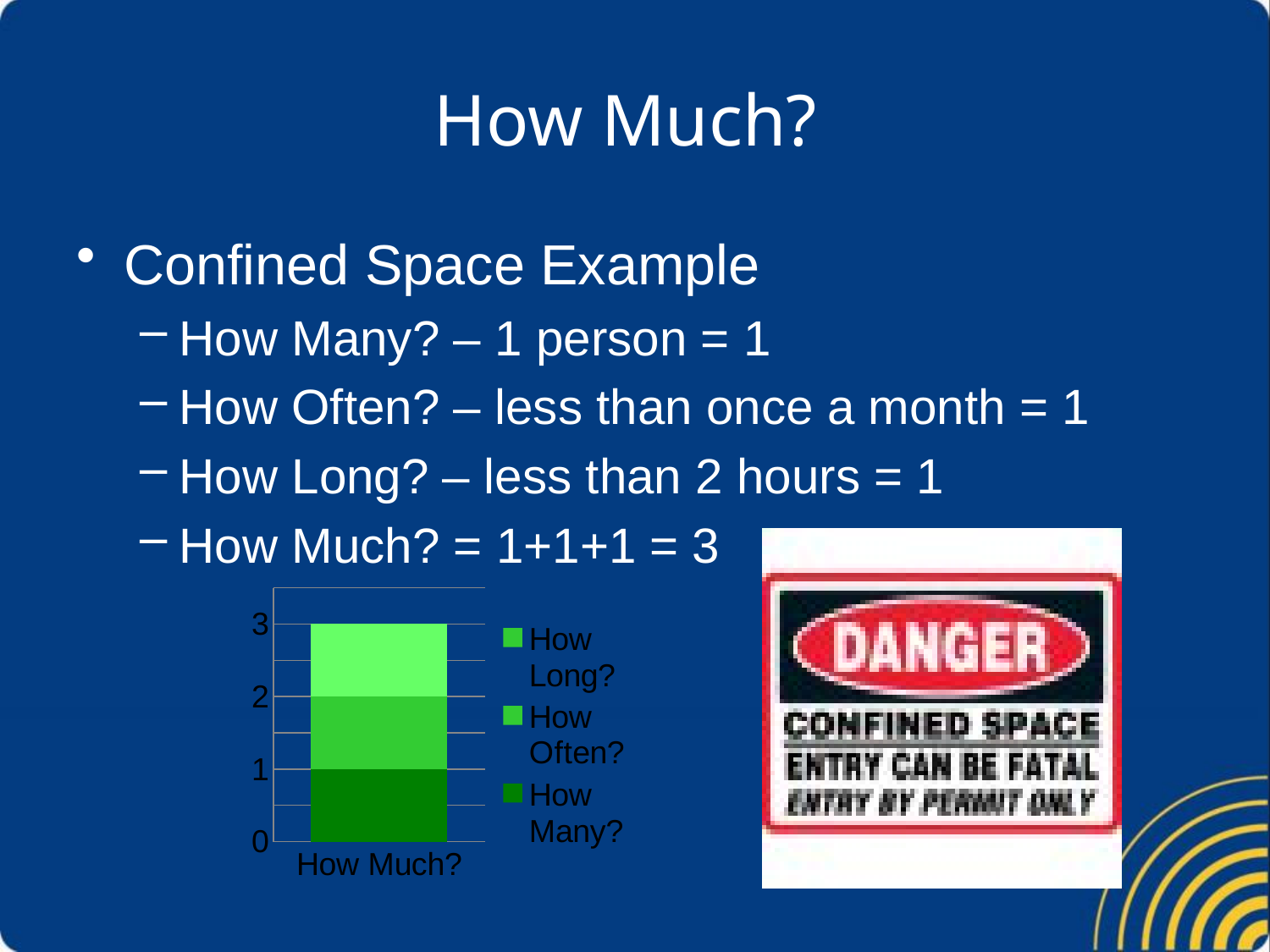
What is the highest value shown on the chart's y axis? 3 Is the total of the stacked bar greater or less than 2? greater What value does the "How Long?" segment contribute to the stacked bar? 1 How many categories are plotted on the x axis of the chart? 1 What value does the "How Often?" segment contribute to the stacked bar? 1 What value does the "How Many?" segment contribute to the stacked bar? 1 What is the total height of the stacked bar for "How Much?"? 3 How many series does the chart legend list? 3 What kind of chart is shown on the slide? stacked bar chart Which legend entry is listed first (at the top) in the chart legend? How Long? What is the category label shown on the x axis of the chart? How Much?